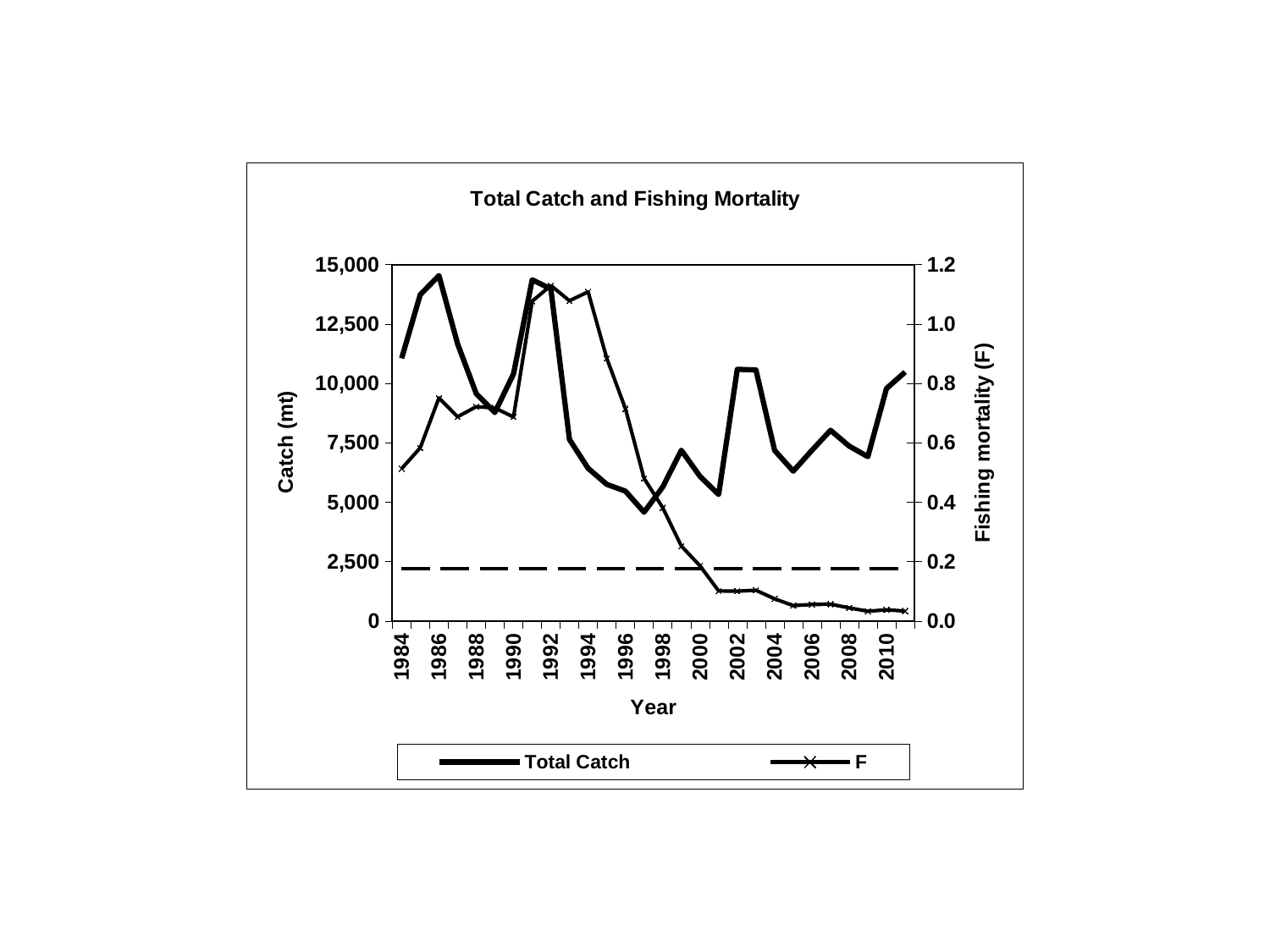
What type of chart is shown on the slide? Line chart Which is larger, the F value in 1992 or in 2000? 1992 Is the F value for 1984 greater or less than 0.4? greater Is the Total Catch value for 1986 greater or less than 12,500? greater Is the F value for 2010 greater or less than 0.2? less How many series does the legend list? 2 Which is larger, the Total Catch in 1984 or in 2001? 1984 What is the label of the right-hand vertical axis? Fishing mortality (F) What is the title of the chart? Total Catch and Fishing Mortality Does the F series rise or fall between 1994 and 2001? Fall